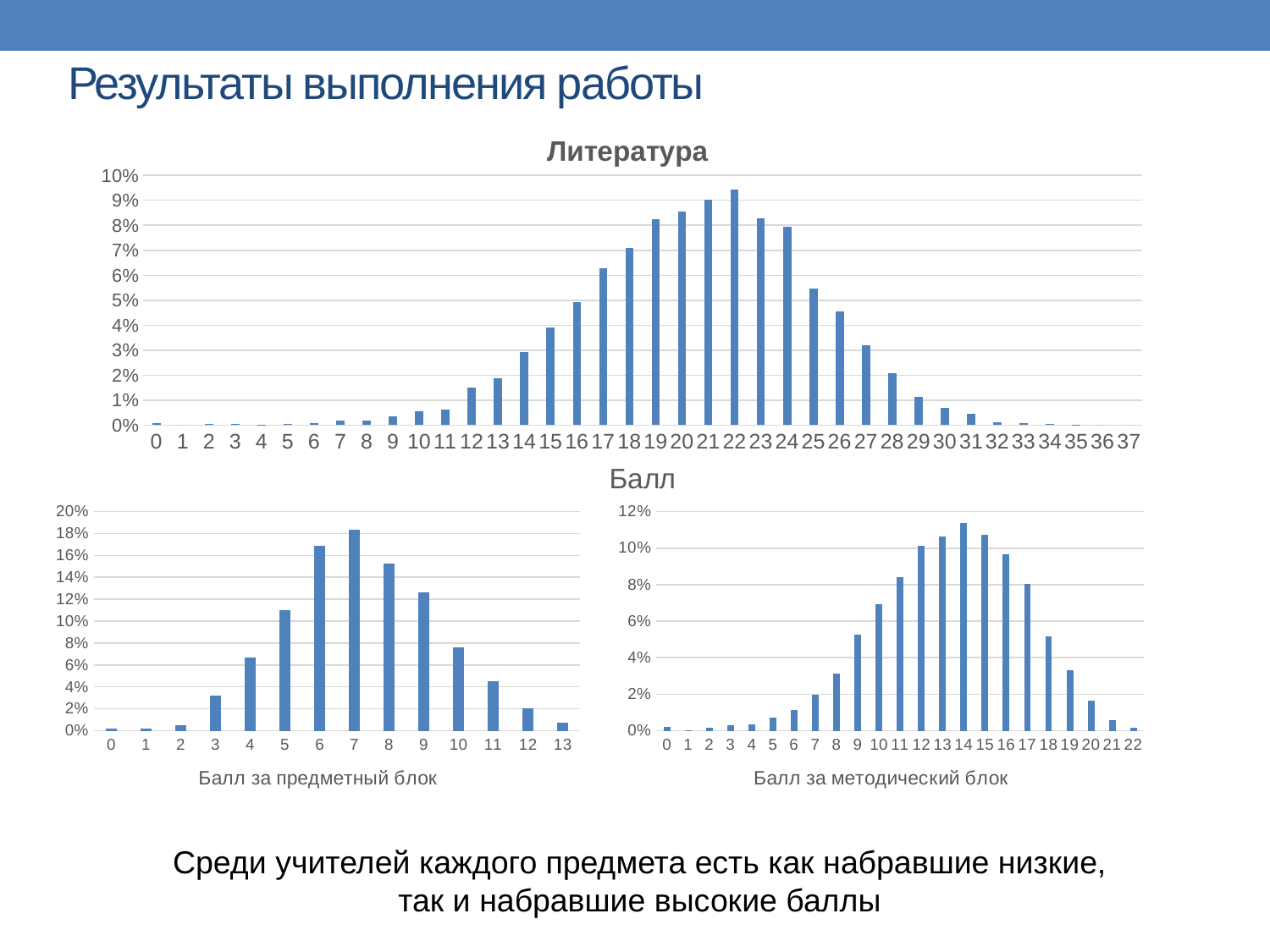
In the top chart (Литература), which score (балл) has the highest share? 22 In the top chart (Литература), is the value for score 26 greater or less than 5%? less How many score categories are shown on the x axis of the top chart (Литература)? 38 In the top chart (Литература), is the value for score 22 greater or less than 9%? greater In the bottom-right chart (Балл за методический блок), which score has the highest share? 14 In the top chart (Литература), is the value for score 30 greater or less than 1%? less What kind of chart is the bottom-left chart (Балл за предметный блок)? bar chart In the bottom-left chart (Балл за предметный блок), which score has the highest share? 7 What is the title of the top chart? Литература In the bottom-left chart (Балл за предметный блок), which is larger, the value for score 6 or the value for score 8? 6